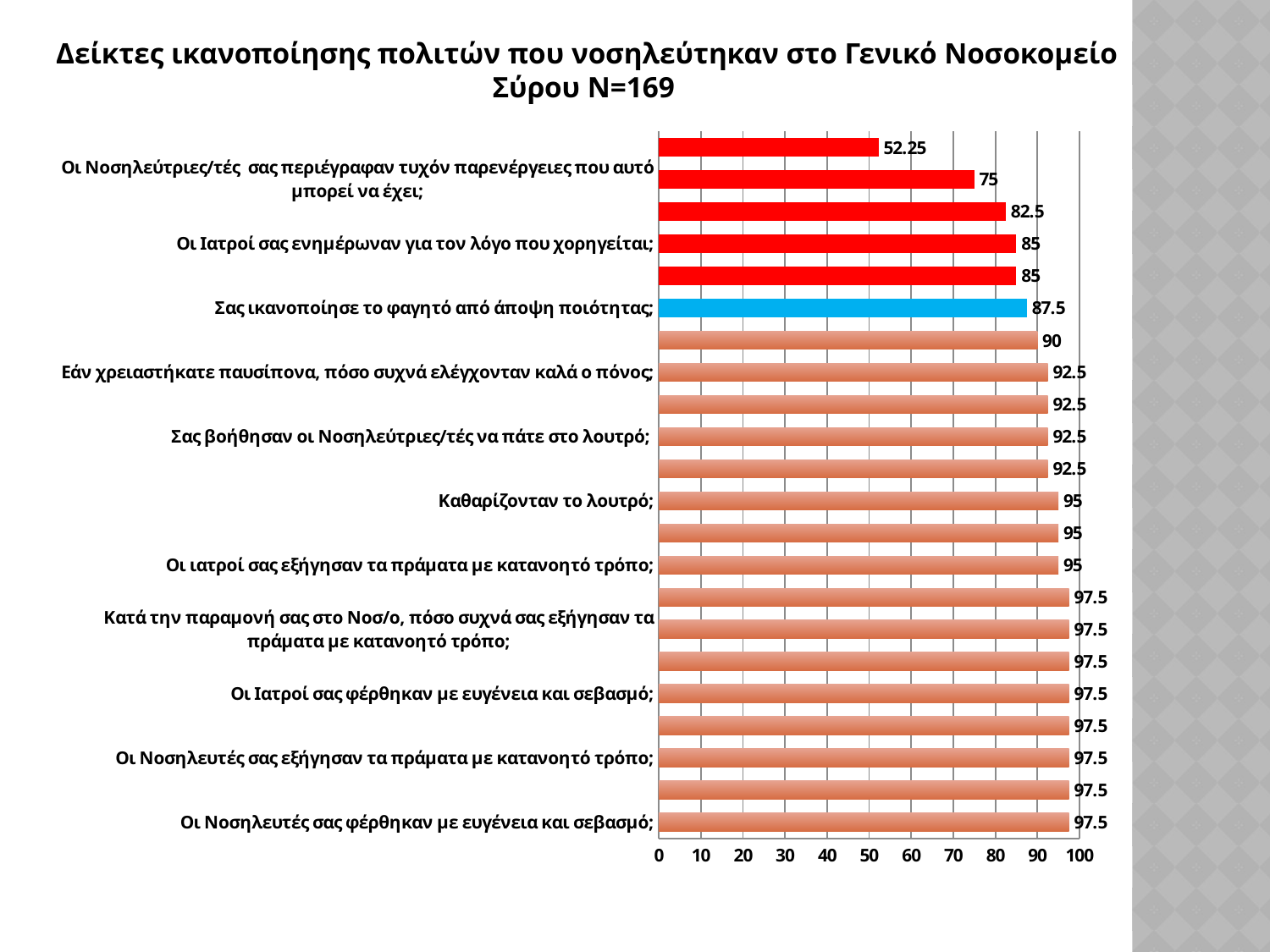
What colour is the bar for 'Σας ικανοποίησε το φαγητό από άποψη ποιότητας;'? blue How many bars are plotted in the chart? 22 What is the value for 'Οι Ιατροί σας ενημέρωναν για τον λόγο που χορηγείται;'? 85 Which is larger: the value for 'Καθαρίζονταν το λουτρό;' or the value for 'Οι Ιατροί σας ενημέρωναν για τον λόγο που χορηγείται;'? Καθαρίζονταν το λουτρό; What is the highest value shown in the chart? 97.5 What is the value for 'Σας ικανοποίησε το φαγητό από άποψη ποιότητας;'? 87.5 What is the value for 'Καθαρίζονταν το λουτρό;'? 95 What kind of chart is shown on the slide? bar chart What is the value for 'Οι Νοσηλευτές σας φέρθηκαν με ευγένεια και σεβασμό;'? 97.5 What is the lowest value shown in the chart? 52.25 What is the difference between the value for 'Οι Ιατροί σας φέρθηκαν με ευγένεια και σεβασμό;' and the value for 'Σας ικανοποίησε το φαγητό από άποψη ποιότητας;'? 10 What is the value for 'Εάν χρειαστήκατε παυσίπονα, πόσο συχνά ελέγχονταν καλά ο πόνος;'? 92.5